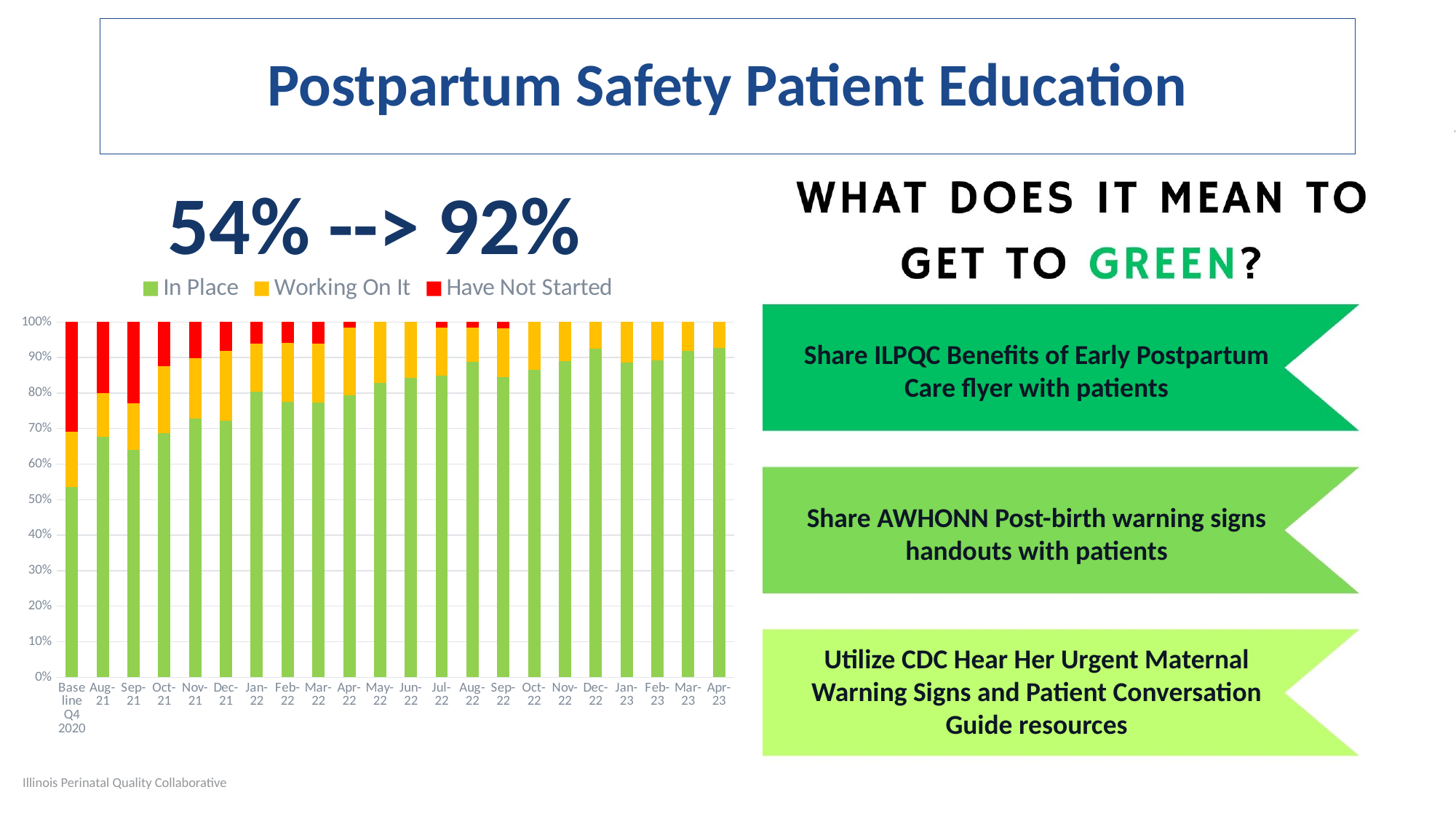
Which series is shown in green in the chart? In Place How many time periods (bars) are plotted on the x axis of the chart? 22 Which series is shown in red in the chart? Have Not Started How many series does the chart legend list? 3 Does the In Place share generally rise or fall from Baseline Q4 2020 to Apr-23? Rise Is the In Place value for Mar-22 greater or less than 80%? less Is the In Place value for Apr-23 greater or less than 90%? greater Which time period has the lowest In Place value? Baseline Q4 2020 Which has a larger In Place value, Baseline Q4 2020 or Apr-23? Apr-23 What kind of chart is shown on the slide? Stacked bar chart Which time period has the highest Have Not Started value? Baseline Q4 2020 Is the In Place value for Baseline Q4 2020 greater or less than 60%? less